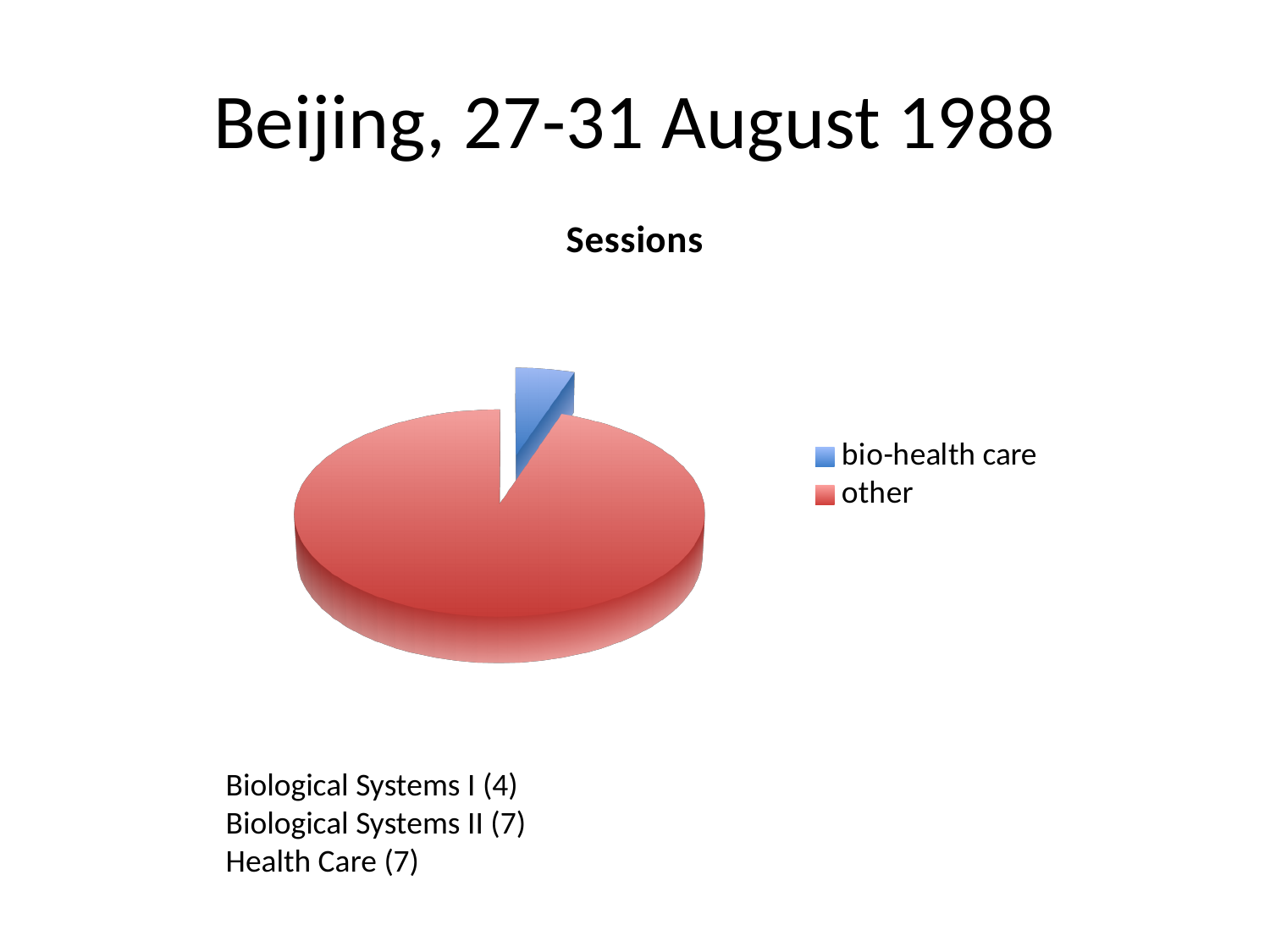
How many entries does the chart legend list? 2 Which slice of the pie chart is the smallest? bio-health care What colour is the bio-health care slice in the pie chart? blue How many slices does the pie chart have? 2 What is the title of the chart? Sessions Which slice of the pie chart is the largest? other What kind of chart is shown on the slide? pie chart Which is larger in the pie chart, bio-health care or other? other